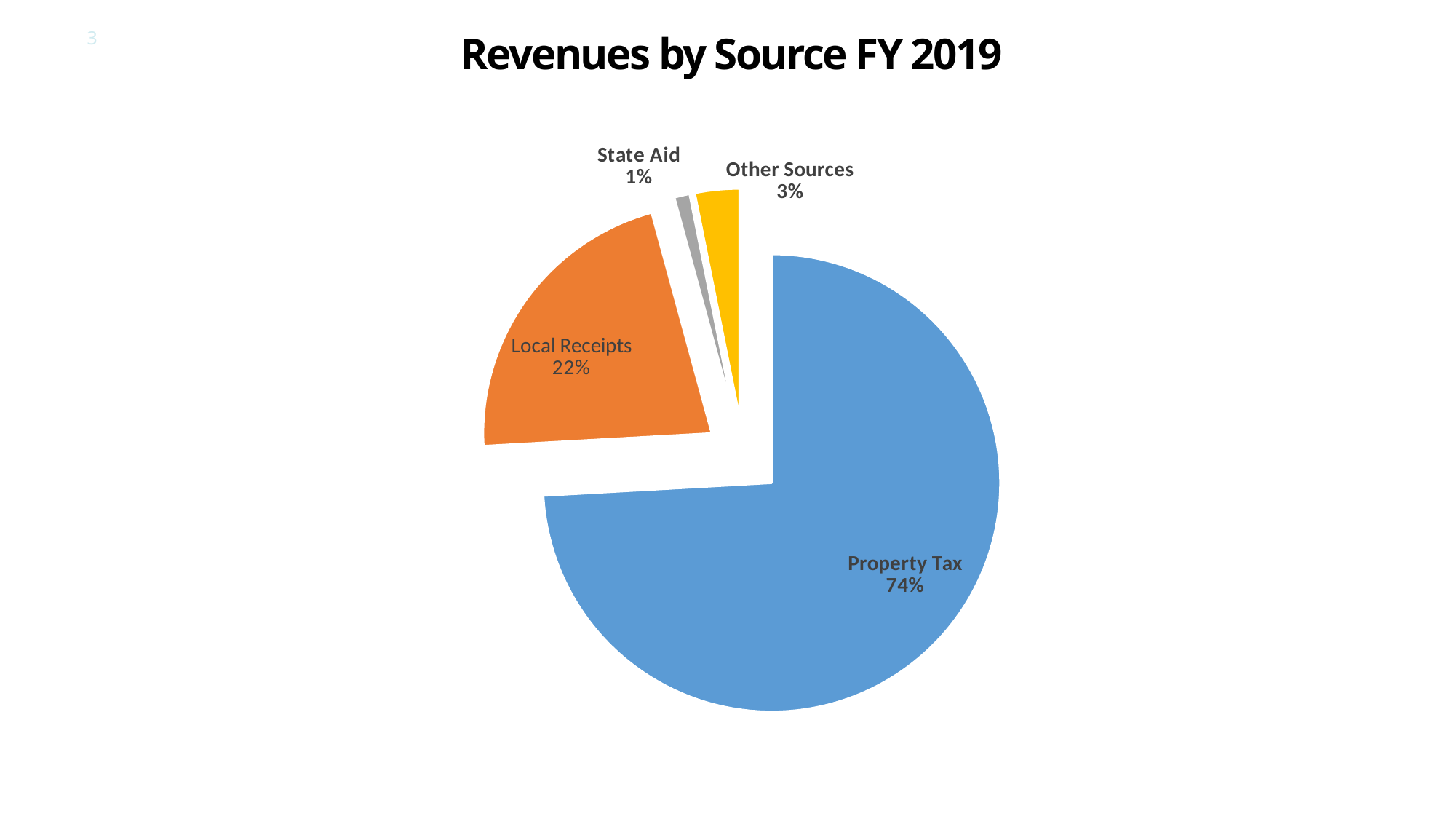
What type of chart is shown on the slide? Pie chart What is the difference in percentage points between Property Tax and Local Receipts? 52 Which revenue source has the largest share? Property Tax What is the title of the chart? Revenues by Source FY 2019 What colour is the Local Receipts slice? Orange What share of revenues comes from Other Sources? 3% What share of revenues comes from Property Tax? 74% What share of revenues comes from State Aid? 1% What share of revenues comes from Local Receipts? 22% How many revenue sources are shown in the pie chart? 4 Which revenue source has the smallest share? State Aid Which is larger, the share for Other Sources or the share for State Aid? Other Sources